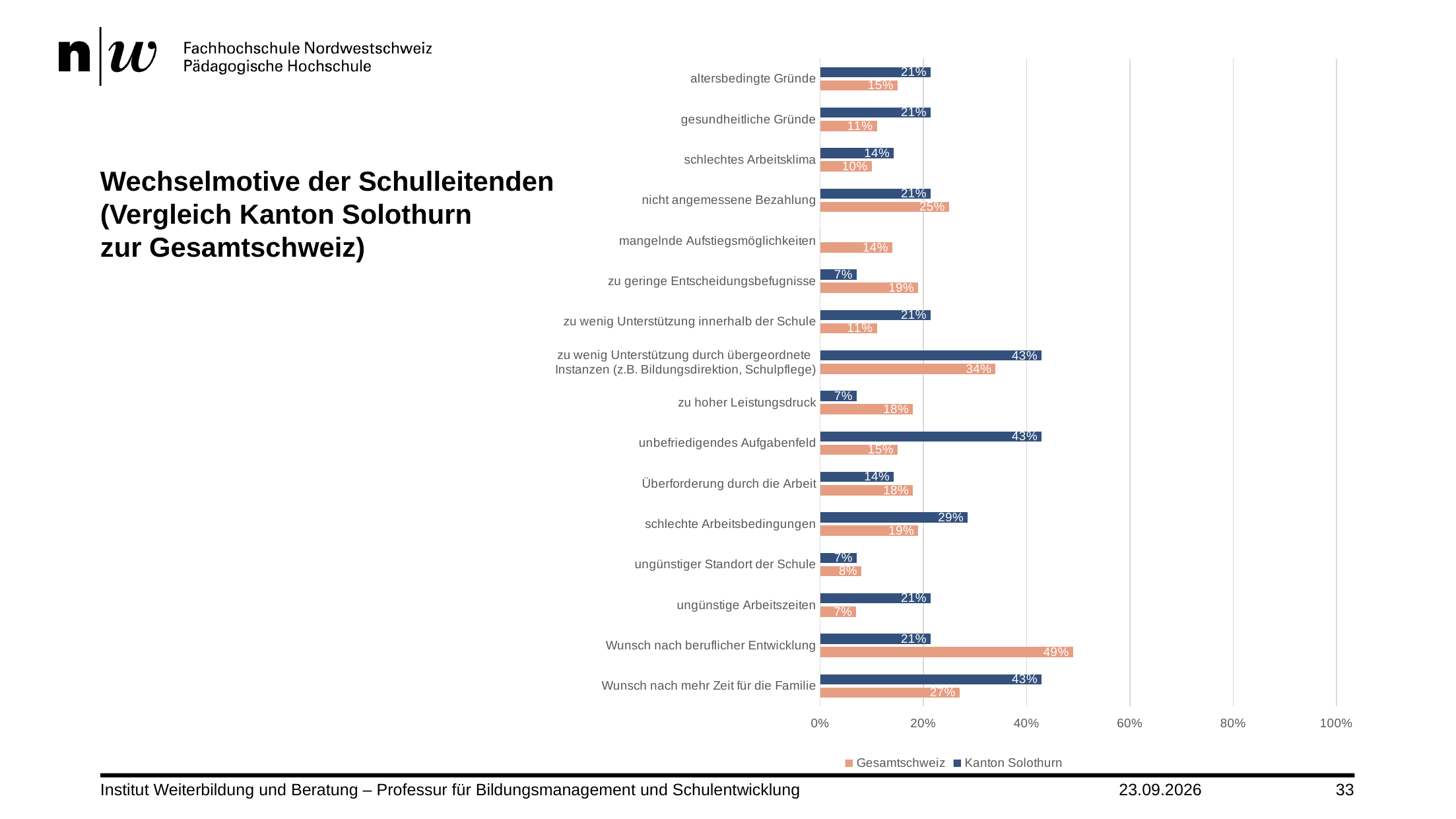
What is the Gesamtschweiz value for 'Wunsch nach beruflicher Entwicklung'? 49% How many series does the legend list? 2 Which category has the highest Gesamtschweiz value? Wunsch nach beruflicher Entwicklung Which category has the lowest Gesamtschweiz value? ungünstige Arbeitszeiten What is the Gesamtschweiz value for 'nicht angemessene Bezahlung'? 25% For 'zu hoher Leistungsdruck', which series has the larger value, Gesamtschweiz or Kanton Solothurn? Gesamtschweiz What is the difference between the Kanton Solothurn and Gesamtschweiz values for 'Wunsch nach mehr Zeit für die Familie'? 16% What is the Kanton Solothurn value for 'unbefriedigendes Aufgabenfeld'? 43% How many categories are shown on the y axis of the chart? 16 Which series is shown in orange according to the legend? Gesamtschweiz What kind of chart is shown on the slide? bar chart Is the Gesamtschweiz value for 'Wunsch nach beruflicher Entwicklung' greater or less than 40%? greater